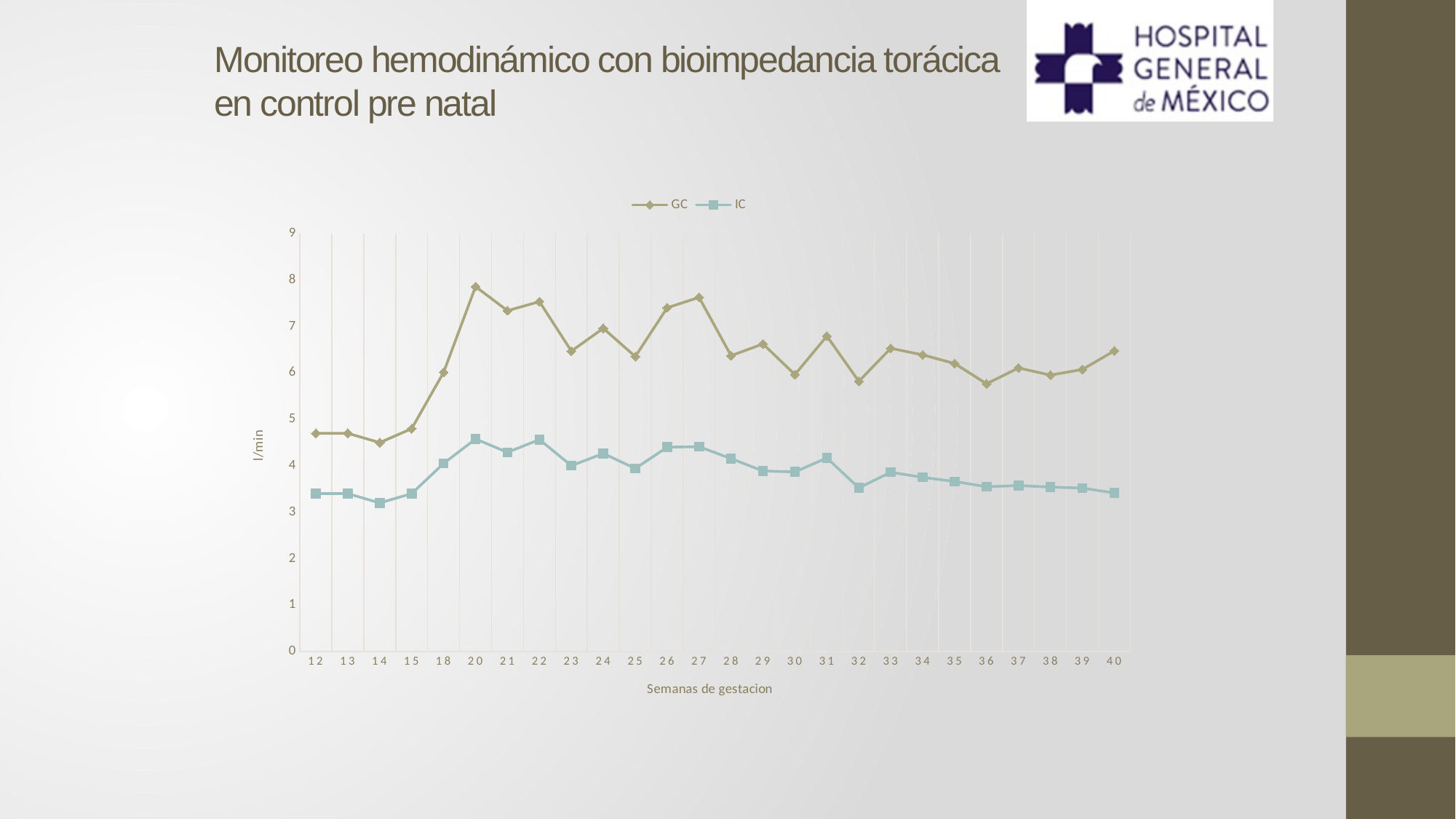
What is the label on the y axis? l/min Is the IC value at week 40 greater or less than 4? less At which gestation week is the GC series at its lowest? 14 At which gestation week is the IC series at its lowest? 14 Is the GC value at week 12 greater or less than 5? less Does the GC series rise or fall between week 15 and week 20? rise Is the GC value at week 20 greater or less than 7? greater How many series does the legend list? 2 Which series has the larger value at week 20, GC or IC? GC What kind of chart is shown on the slide? line chart How many gestation weeks are plotted along the x axis? 26